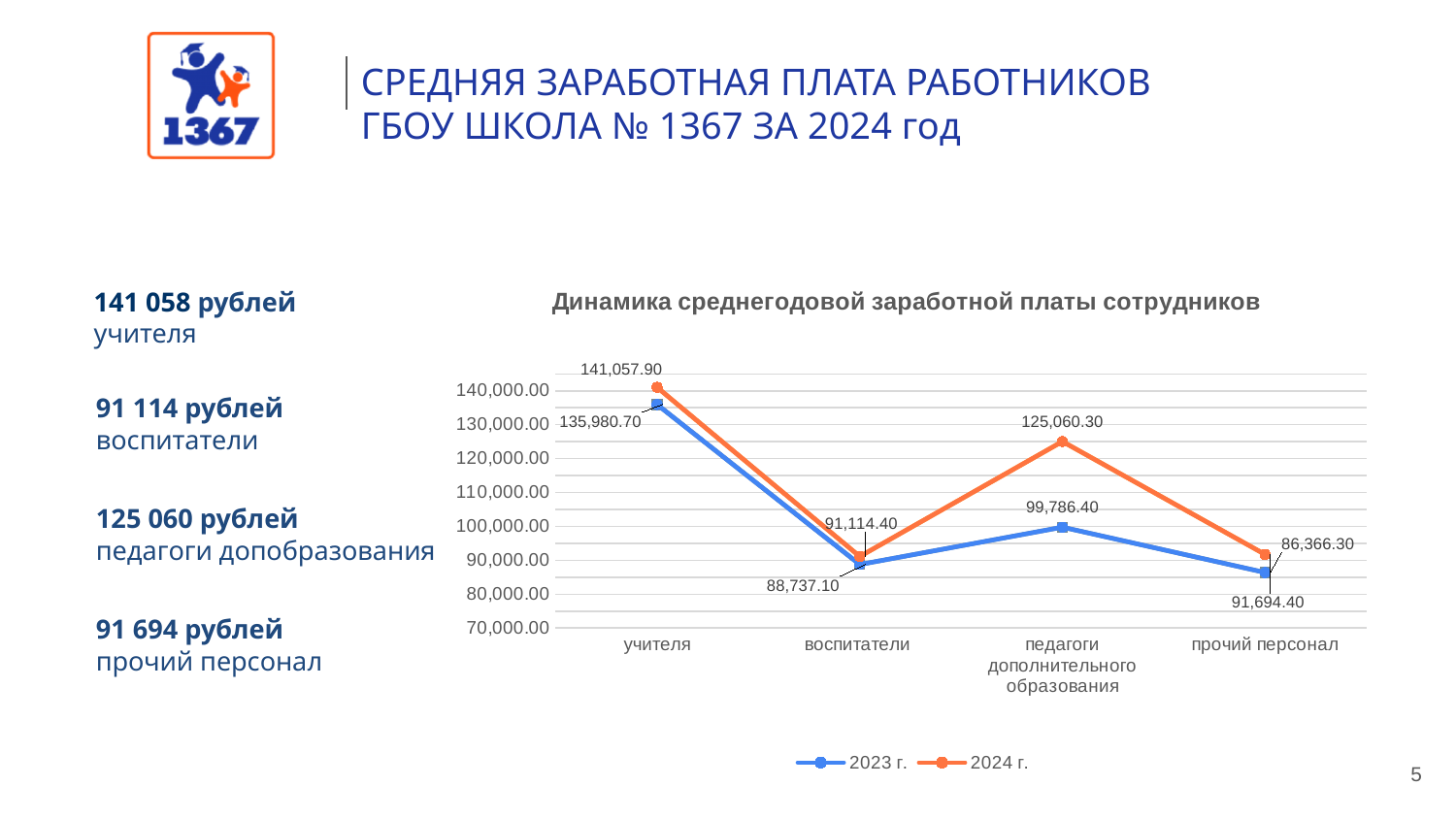
What is the 2023 г. value for учителя? 135,980.70 What is the 2024 г. value for педагоги дополнительного образования? 125,060.30 How many series does the chart legend list? 2 How many categories are plotted along the x axis of the chart? 4 What is the 2023 г. value for воспитатели? 88,737.10 Which category has the highest 2024 г. value? учителя What is the difference between the 2024 г. and 2023 г. values for педагоги дополнительного образования? 25,273.90 What is the 2024 г. value for учителя? 141,057.90 Is the 2023 г. value for педагоги дополнительного образования greater or less than 110,000.00? less What is the difference between the 2024 г. and 2023 г. values for учителя? 5,077.20 What kind of chart is shown on the slide? line chart What is the 2024 г. value for воспитатели? 91,114.40